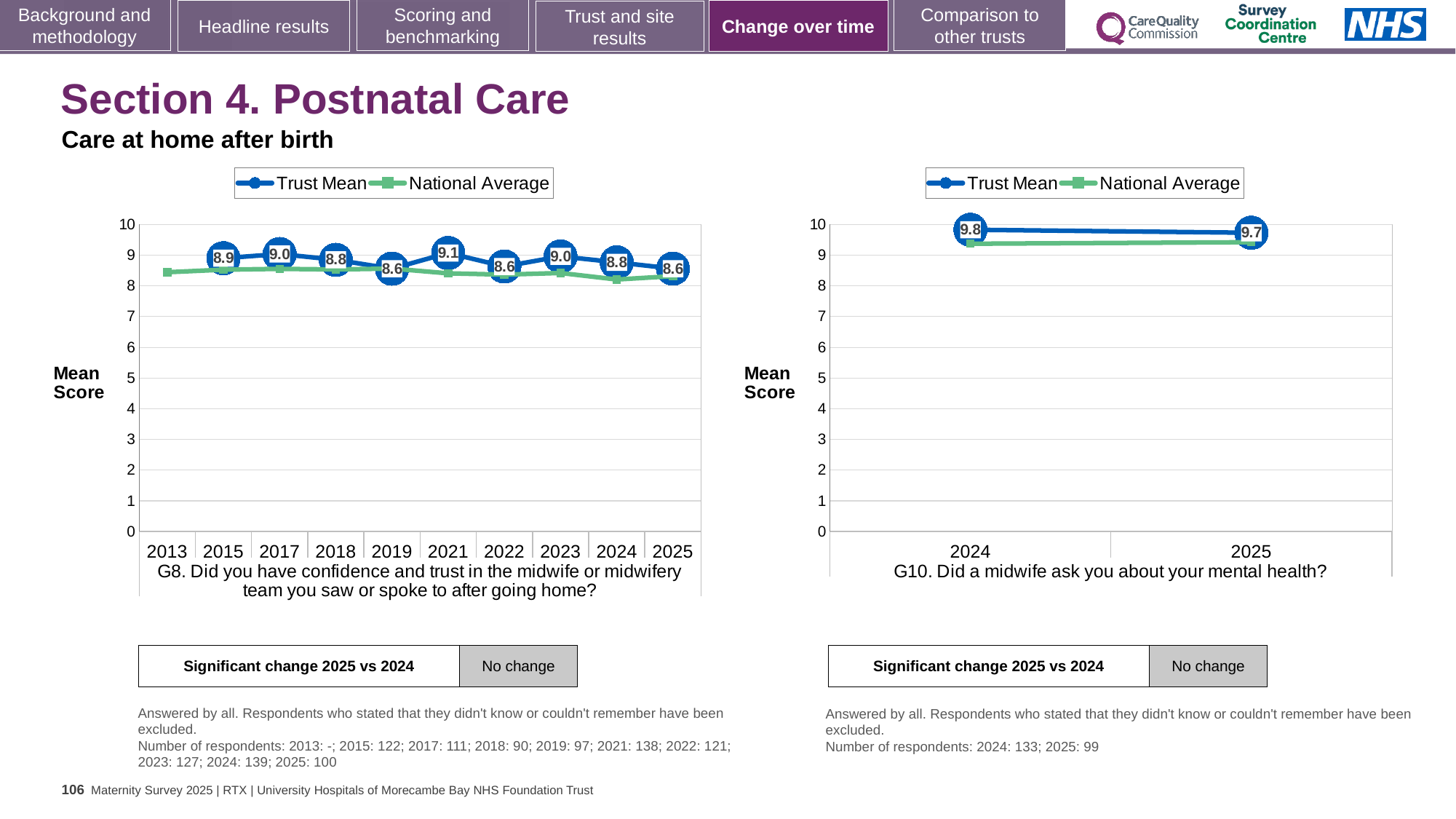
In the G10 chart on the right, what is the Trust Mean for 2024? 9.8 In the G8 chart on the left, is the Trust Mean higher in 2017 or in 2018? 2017 In the G8 chart on the left, what is the Trust Mean for 2025? 8.6 In the G8 chart on the left, what is the difference between the Trust Mean in 2021 and in 2025? 0.5 In the G8 chart on the left, which year has the highest Trust Mean? 2021 What kind of chart is the G10 chart on the right? Line chart What are the two legend entries in the G8 chart on the left? Trust Mean and National Average How many years are shown on the x axis of the G8 chart on the left? 10 In the G8 chart on the left, is the National Average for 2013 greater or less than 9? less In the G10 chart on the right, does the Trust Mean rise or fall from 2024 to 2025? Fall In the G8 chart on the left, what is the Trust Mean for 2021? 9.1 How many series does the legend of the G10 chart on the right list? 2